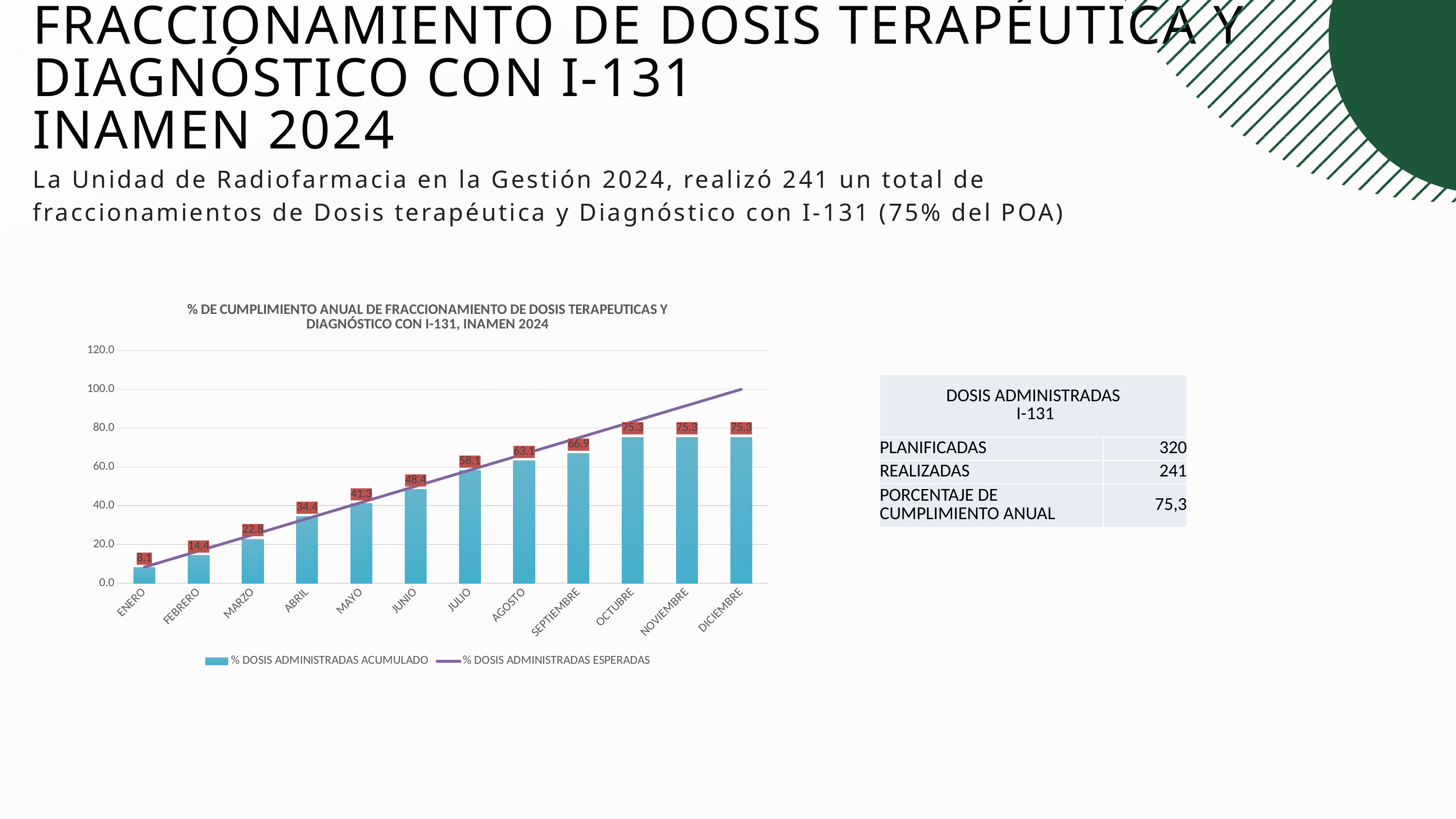
What colour are the bars for % DOSIS ADMINISTRADAS ACUMULADO? Blue How many months are shown on the x axis of the chart? 12 What kind of chart is used to show % DOSIS ADMINISTRADAS ACUMULADO? Bar chart Which month has the lowest value of % DOSIS ADMINISTRADAS ACUMULADO? ENERO How many series does the chart legend list? 2 What is the difference between the % DOSIS ADMINISTRADAS ACUMULADO values for AGOSTO and JULIO? 5.0 What is the value of % DOSIS ADMINISTRADAS ACUMULADO for DICIEMBRE? 75.3 What is the value of % DOSIS ADMINISTRADAS ACUMULADO for ENERO? 8.1 Which is larger, the % DOSIS ADMINISTRADAS ACUMULADO value for ABRIL or for MAYO? MAYO Do the % DOSIS ADMINISTRADAS ACUMULADO values rise or fall from ENERO to OCTUBRE? Rise What is the value of % DOSIS ADMINISTRADAS ACUMULADO for JULIO? 58.1 Is the % DOSIS ADMINISTRADAS ESPERADAS line value for DICIEMBRE greater or less than 80.0? greater